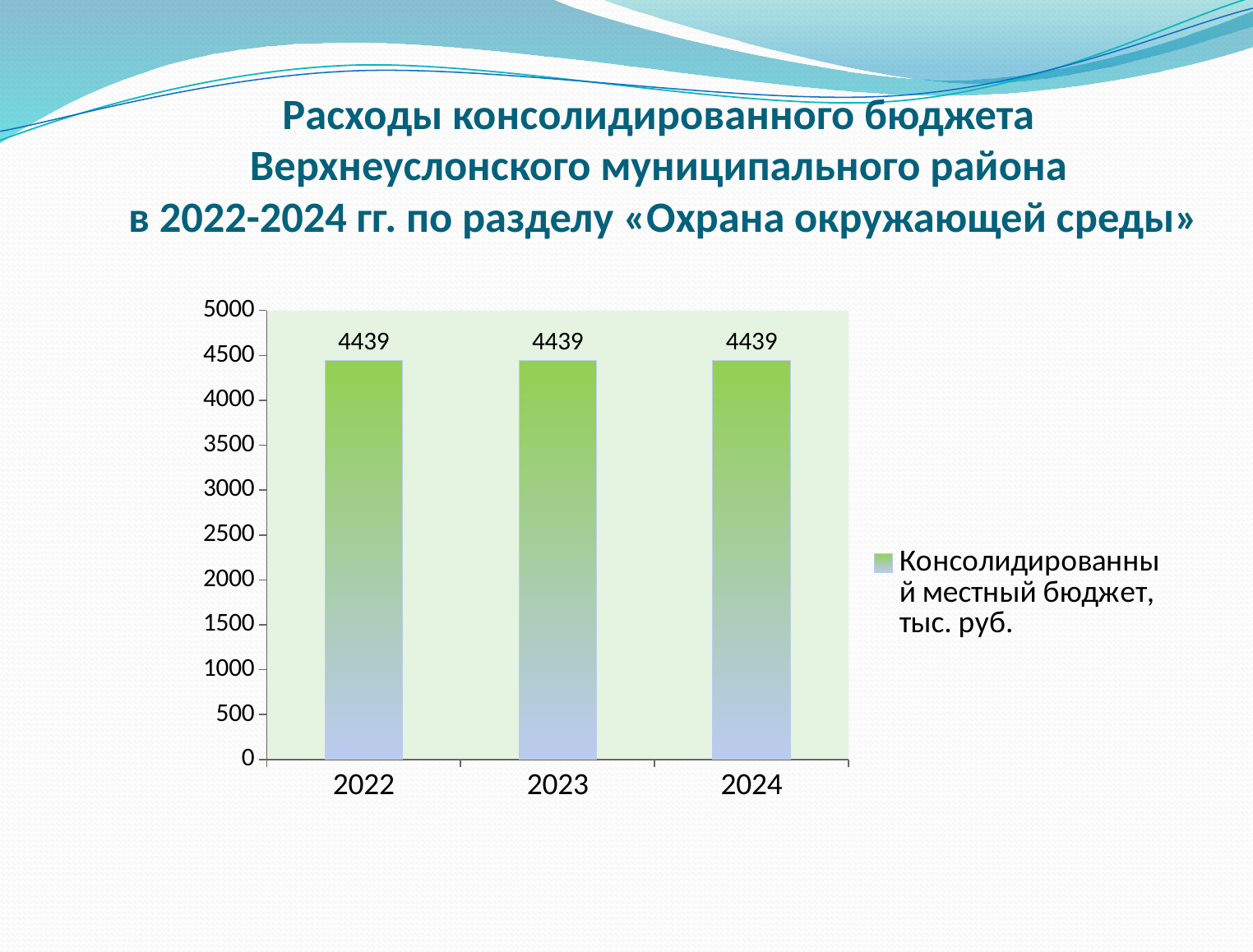
Which budget section is named in the slide title? Охрана окружающей среды What is the value for 2024? 4439 How many series does the legend list? 1 What series name does the legend show? Консолидированный местный бюджет, тыс. руб. What is the difference between the values for 2022 and 2024? 0 Do the values rise, fall or stay the same from 2022 to 2024? stay the same What is the value for 2022? 4439 Is the value for 2023 greater or less than 4000? greater What kind of chart is shown on the slide? bar chart How many years are shown on the x axis? 3 Is the value for 2024 greater or less than 5000? less What is the value for 2023? 4439